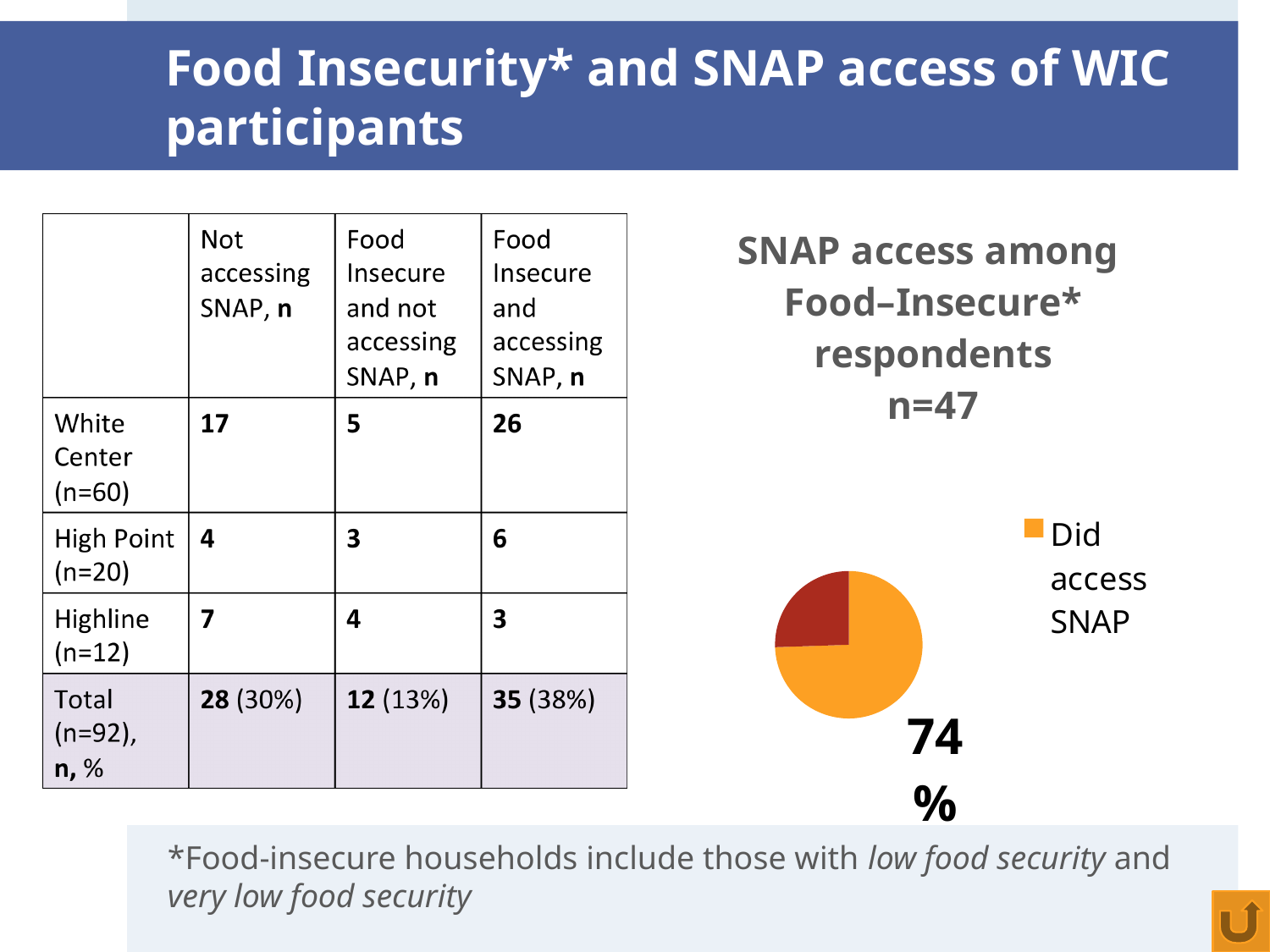
Which slice of the pie chart is larger, the orange slice or the red slice? the orange slice How many entries does the pie chart's legend list? 1 How many slices does the pie chart have? 2 Is the share for "Did access SNAP" greater or less than 50%? greater How many respondents does the pie chart's title say it covers? n=47 What is the title of the pie chart? SNAP access among Food–Insecure* respondents n=47 What share of the pie chart is labelled for "Did access SNAP"? 74% Which category takes up the largest share of the pie chart? Did access SNAP What colour is the "Did access SNAP" slice in the pie chart? orange What kind of chart is shown on the slide? pie chart